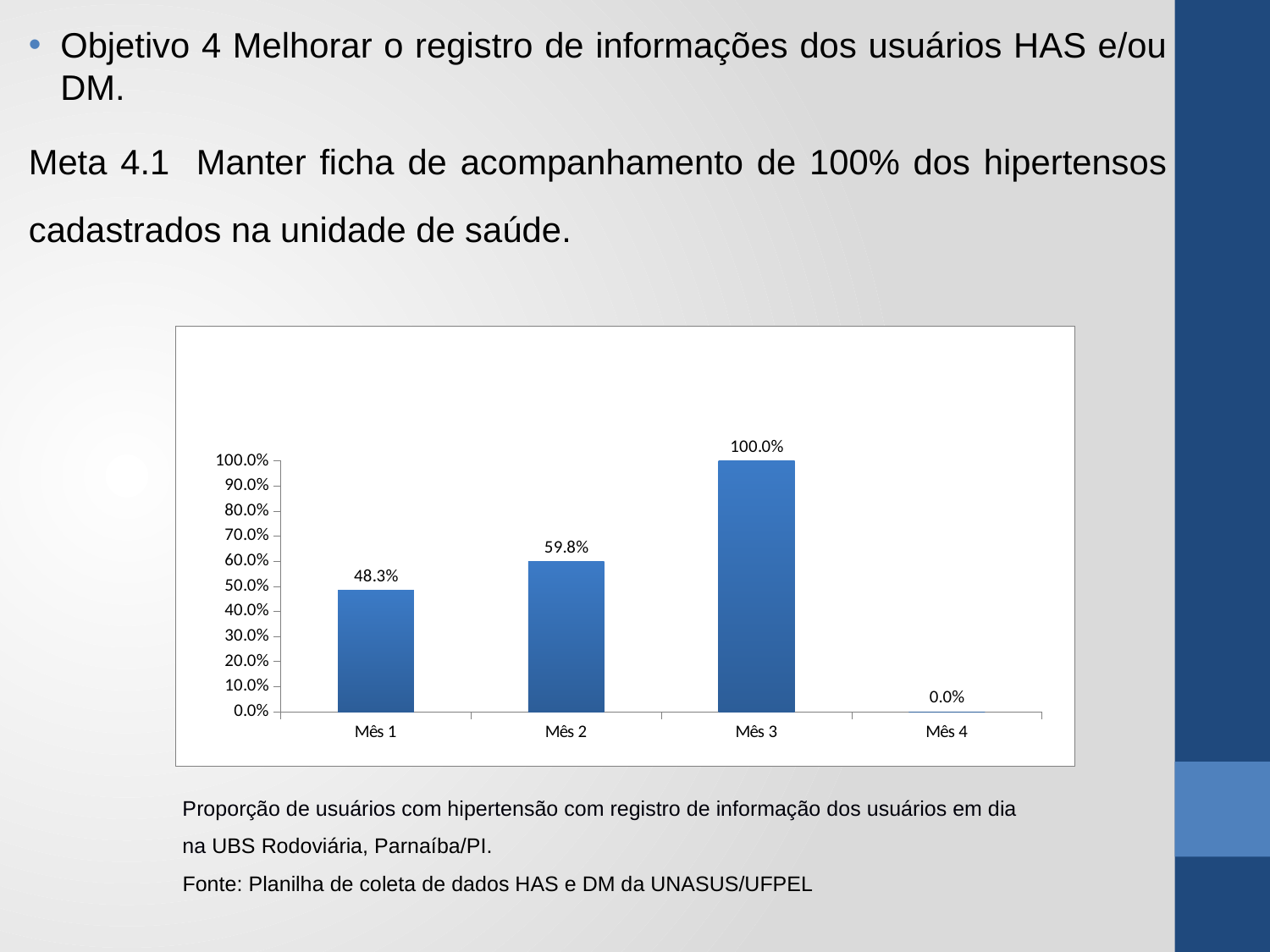
What is the value for Mês 3? 100.0% Which is larger, the value for Mês 1 or the value for Mês 2? Mês 2 Do the values rise or fall from Mês 1 to Mês 3? Rise What is the value for Mês 2? 59.8% What is the difference between the values for Mês 2 and Mês 1? 11.5% Which month has the lowest value? Mês 4 What kind of chart is shown on the slide? Bar chart What is the value for Mês 4? 0.0% How many months are shown on the x axis of the chart? 4 Which month has the highest value? Mês 3 What is the difference between the values for Mês 3 and Mês 2? 40.2% What is the value for Mês 1? 48.3%